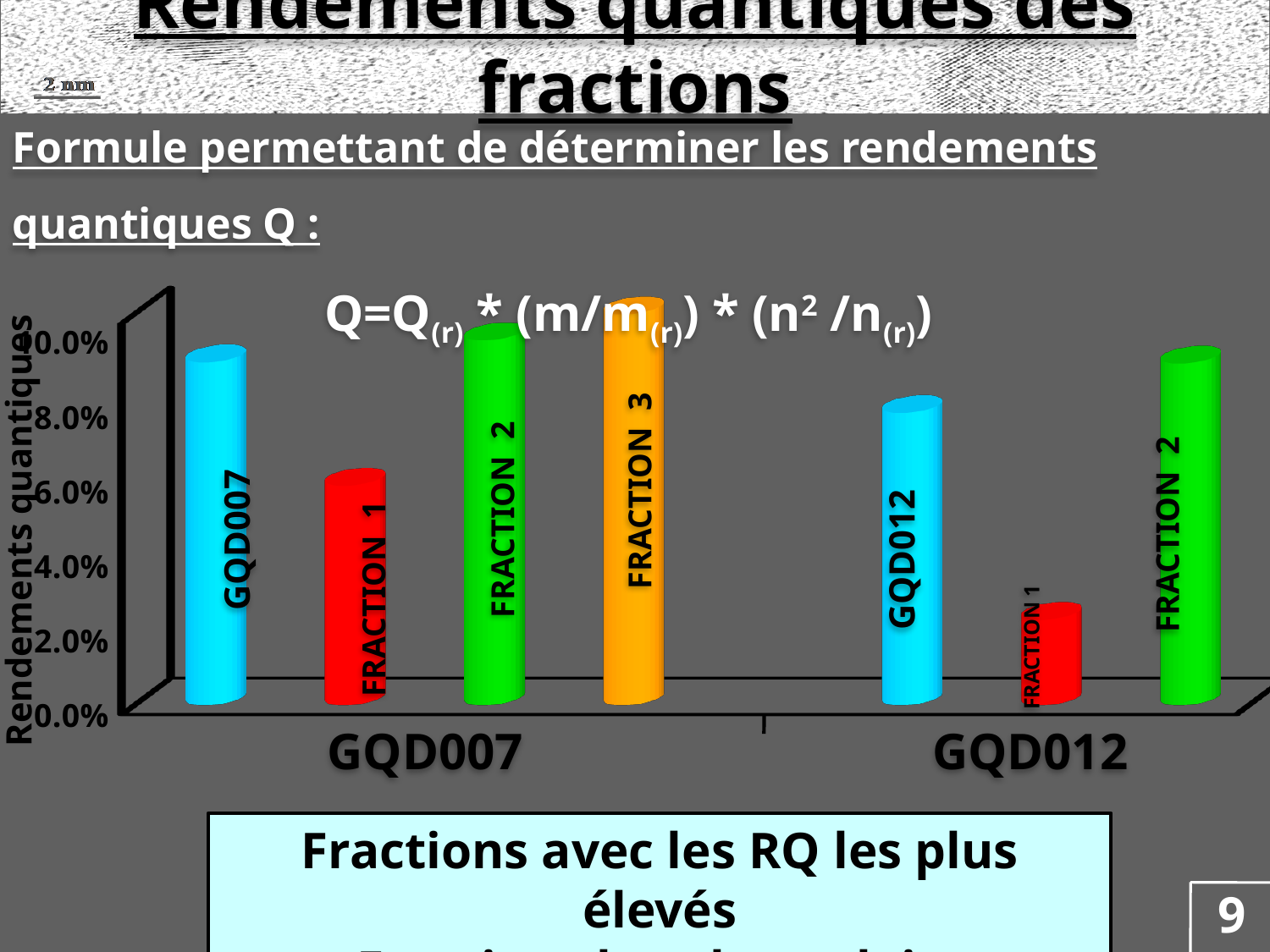
Is the value for FRACTION 1 in the GQD012 group greater or less than 4.0%? less Is the value for the GQD012 bar in the GQD012 group greater or less than 6.0%? greater How many categories are shown on the x axis of the chart? 2 What is the title of the vertical axis of the chart? Rendements quantiques How many bars are plotted in the GQD007 group? 4 Is the value for the GQD007 bar in the GQD007 group greater or less than 8.0%? greater Which bar is the lowest in the GQD012 group? FRACTION 1 Which bar is the lowest in the whole chart? FRACTION 1 in the GQD012 group Which is larger, FRACTION 1 in the GQD007 group or FRACTION 1 in the GQD012 group? FRACTION 1 in the GQD007 group Which bar is the highest in the GQD007 group? FRACTION 3 What kind of chart is shown on the slide? bar chart How many bars are plotted in the GQD012 group? 3